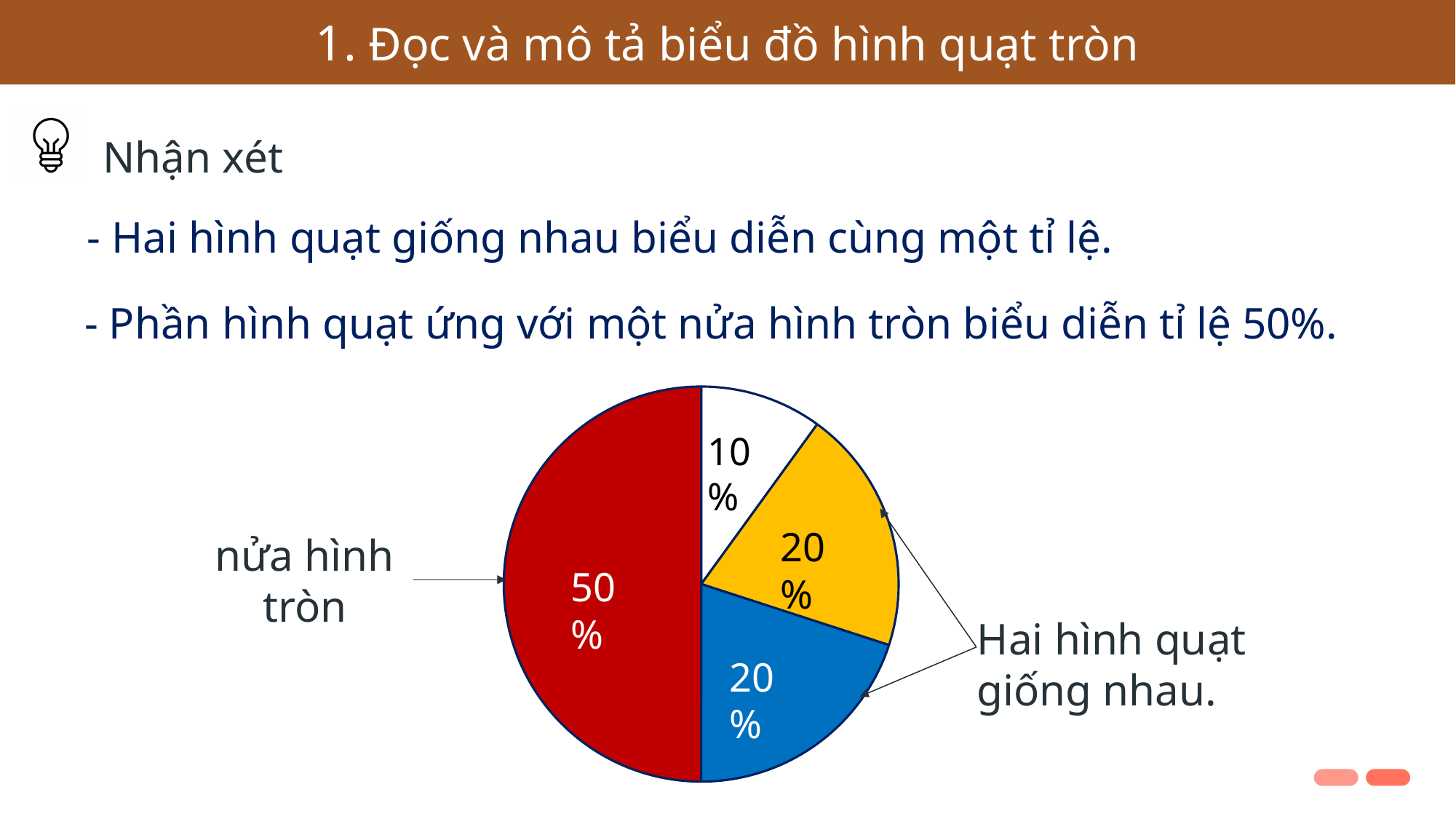
What percentage does the blue slice of the pie chart represent? 20% What percentage does the white slice of the pie chart represent? 10% What percentage does the yellow slice of the pie chart represent? 20% Which slice of the pie chart is the smallest? the white slice (10%) What percentage does the red slice of the pie chart represent? 50% How many slices does the pie chart have? 4 What is the combined share of the yellow and blue slices of the pie chart? 40% Which slice of the pie chart is the largest? the red slice (50%) What is the difference between the red slice and the white slice of the pie chart? 40% What kind of chart is shown on the slide? pie chart Which is larger in the pie chart, the yellow slice or the white slice? the yellow slice Which slice of the pie chart is labelled as half the circle ("nửa hình tròn")? the red slice (50%)